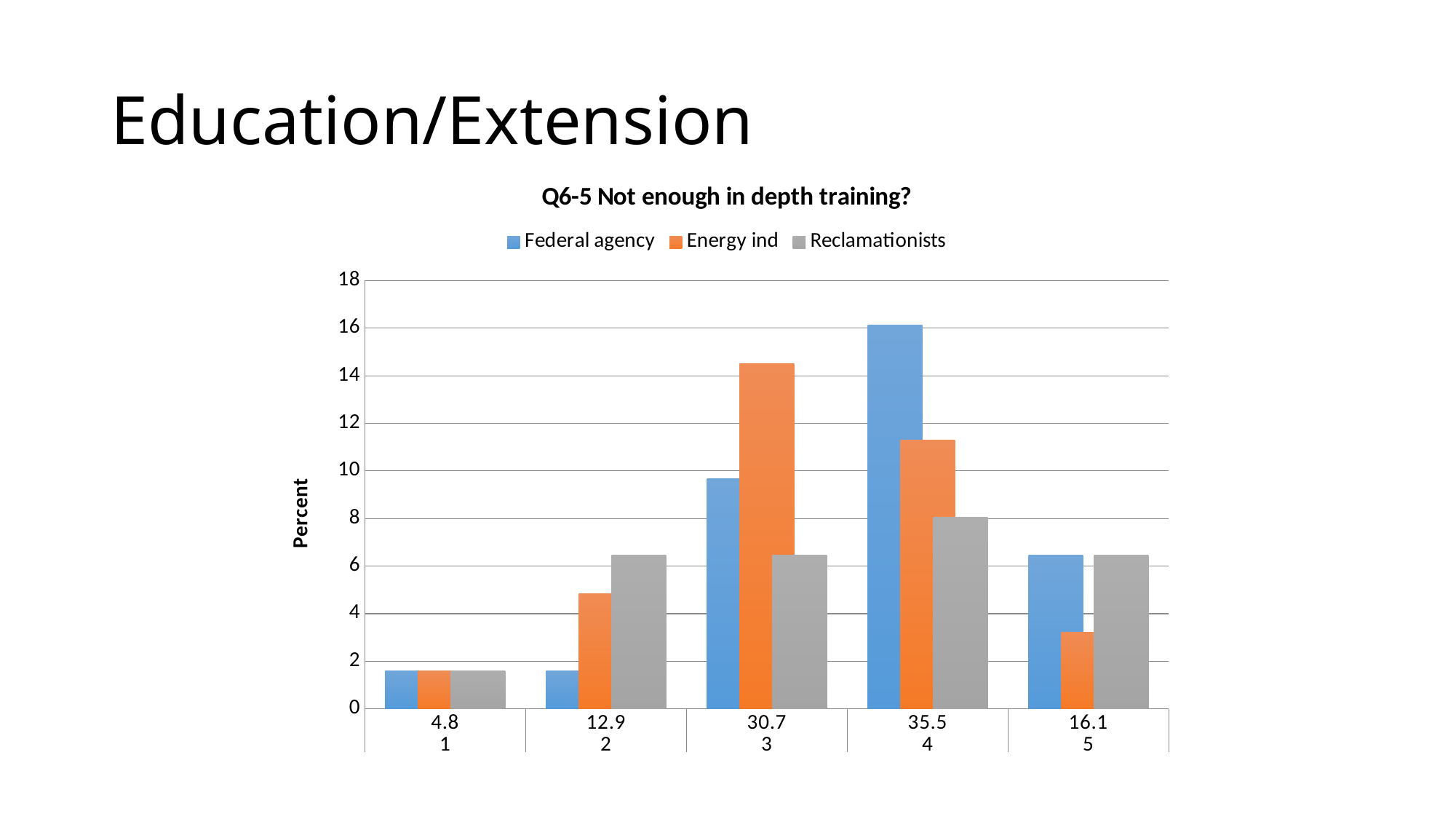
In category 2, which is larger: the Energy ind bar or the Federal agency bar? Energy ind How many categories are shown along the x axis? 5 Which series has the lowest bar in category 5? Energy ind What is the title of the chart? Q6-5 Not enough in depth training? In category 4, which is larger: the Federal agency bar or the Reclamationists bar? Federal agency In which category is the Federal agency bar the highest? 4 How many series does the legend list? 3 Is the Reclamationists value for category 2 greater or less than 8? less Is the Energy ind value for category 3 greater or less than 12? greater What kind of chart is shown on the slide? bar chart Is the Federal agency value for category 4 greater or less than 14? greater Which series has the highest bar in category 3? Energy ind